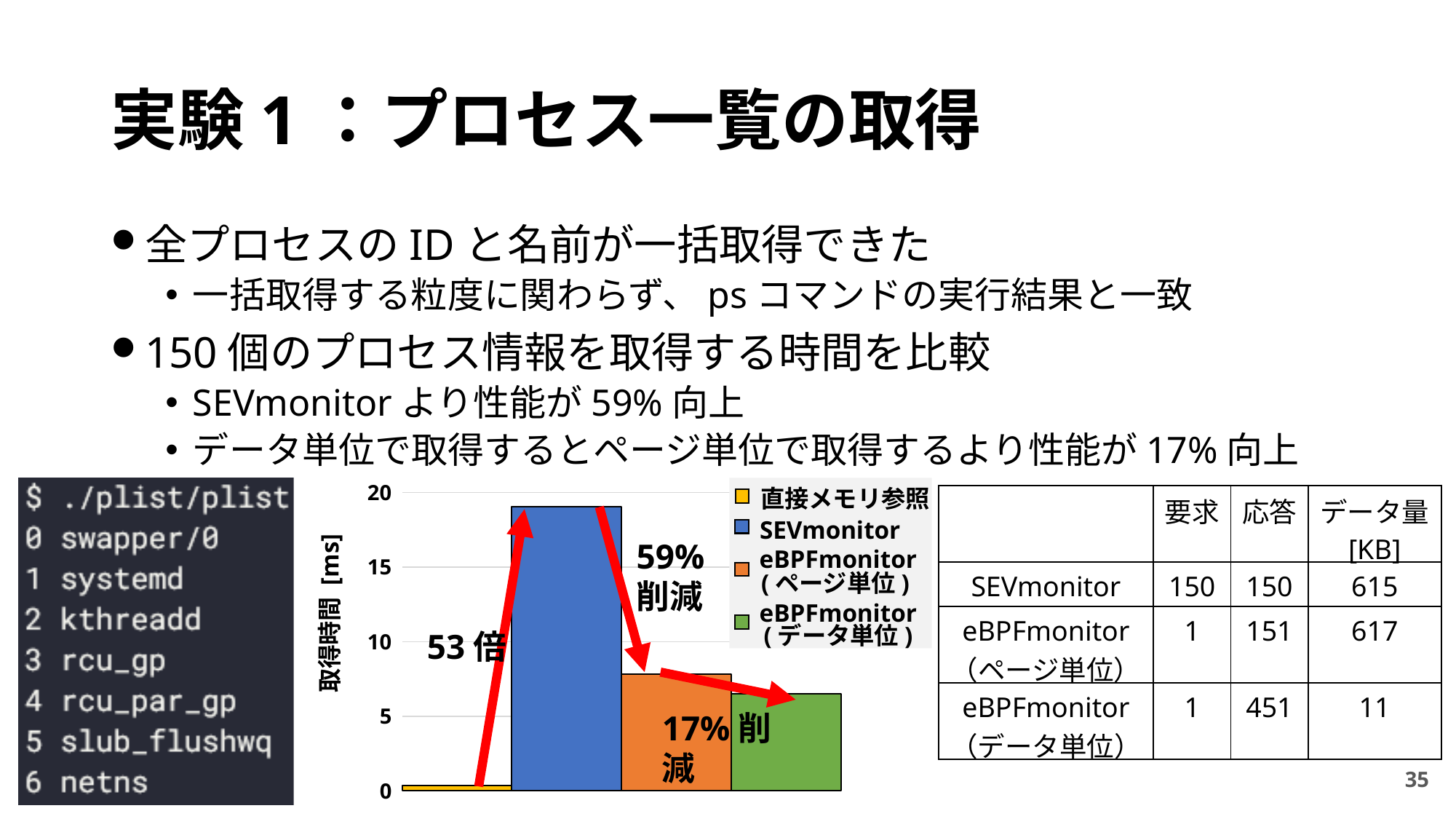
Which has a larger 取得時間, eBPFmonitor (ページ単位) or eBPFmonitor (データ単位)? eBPFmonitor (ページ単位) Is the value for eBPFmonitor (ページ単位) greater or less than 10? less Is the value for eBPFmonitor (データ単位) greater or less than 5? greater Which has a larger 取得時間, SEVmonitor or eBPFmonitor (データ単位)? SEVmonitor What is the label of the chart's vertical axis? 取得時間 [ms] Which series has the highest 取得時間 in the chart? SEVmonitor Is the value for SEVmonitor greater or less than 15? greater How many series does the chart's legend list? 4 What kind of chart is shown on the slide? bar chart What colour is the SEVmonitor bar in the chart? blue Which series has the lowest 取得時間 in the chart? 直接メモリ参照